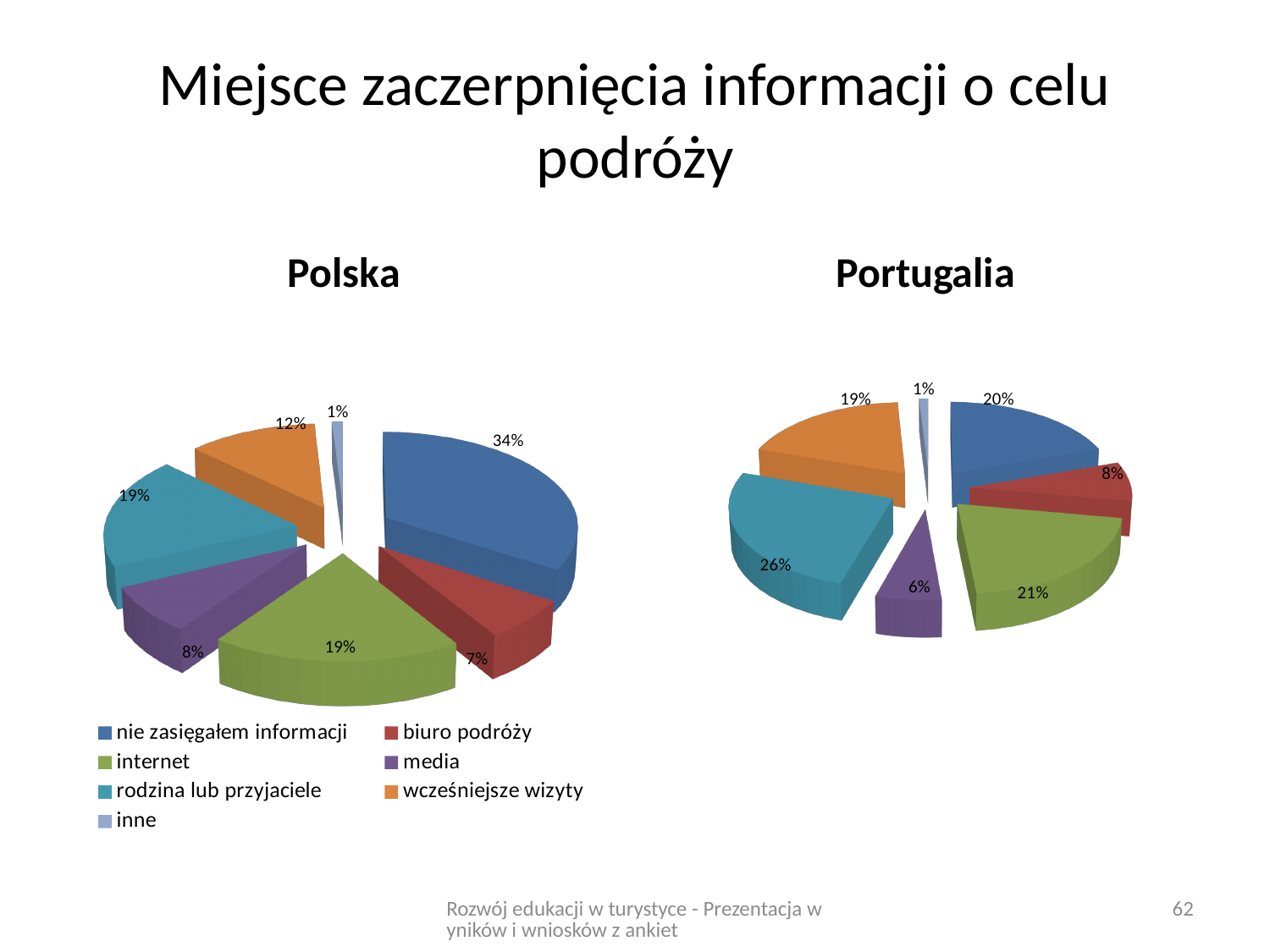
In the Portugalia chart, what share is labelled for "rodzina lub przyjaciele"? 26% In the Polska chart, what share is labelled for "biuro podróży"? 7% In the Polska chart, which category has the largest slice? nie zasięgałem informacji How many slices does the Polska pie chart have? 7 In the Portugalia chart, what share is labelled for "media"? 6% In the Polska chart, what share is labelled for "nie zasięgałem informacji"? 34% What is the difference between the "internet" share in the Portugalia chart and the "internet" share in the Polska chart? 2% How many entries does the legend list? 7 Is the "wcześniejsze wizyty" share larger in the Polska chart or in the Portugalia chart? Portugalia In the Polska chart, which category has the smallest slice? inne What type of chart is used for Polska and Portugalia? Pie chart In the Portugalia chart, which category has the largest slice? rodzina lub przyjaciele